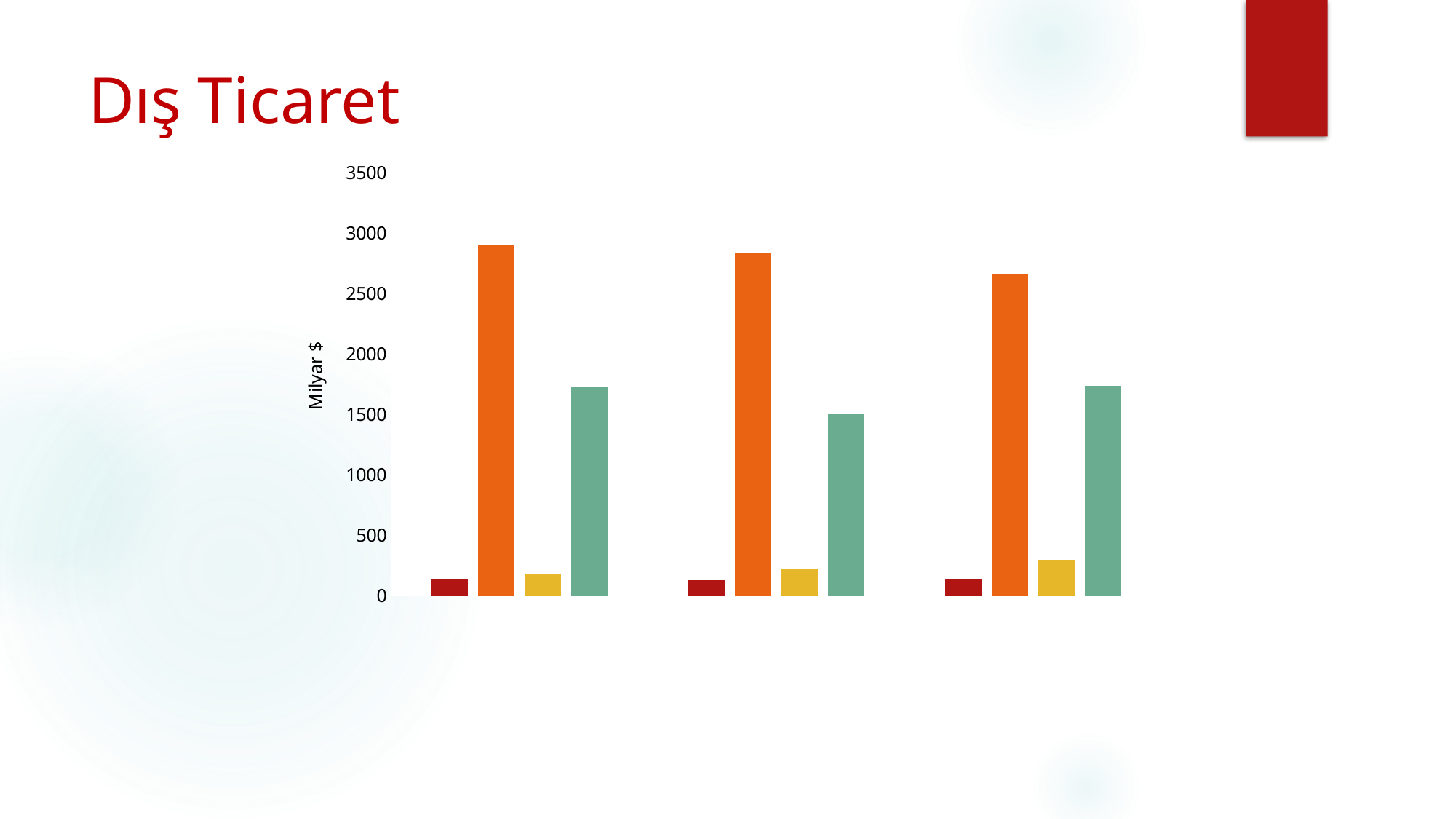
Which coloured bar is the tallest in the first (leftmost) group? orange How many bars are there in each group of the chart? 4 How many groups of bars does the chart show? 3 Which coloured bar is the shortest in the third (rightmost) group? red What is the label on the vertical axis of the chart? Milyar $ What kind of chart is shown on the slide? bar chart Do the orange bars rise or fall from the first group to the third group? fall Is the value of the orange bar in the third group greater or less than 3000? less Which is larger: the orange bar in the first group or the orange bar in the third group? the orange bar in the first group Is the value of the green bar in the first group greater or less than 1500? greater Is the value of the orange bar in the first group greater or less than 2500? greater